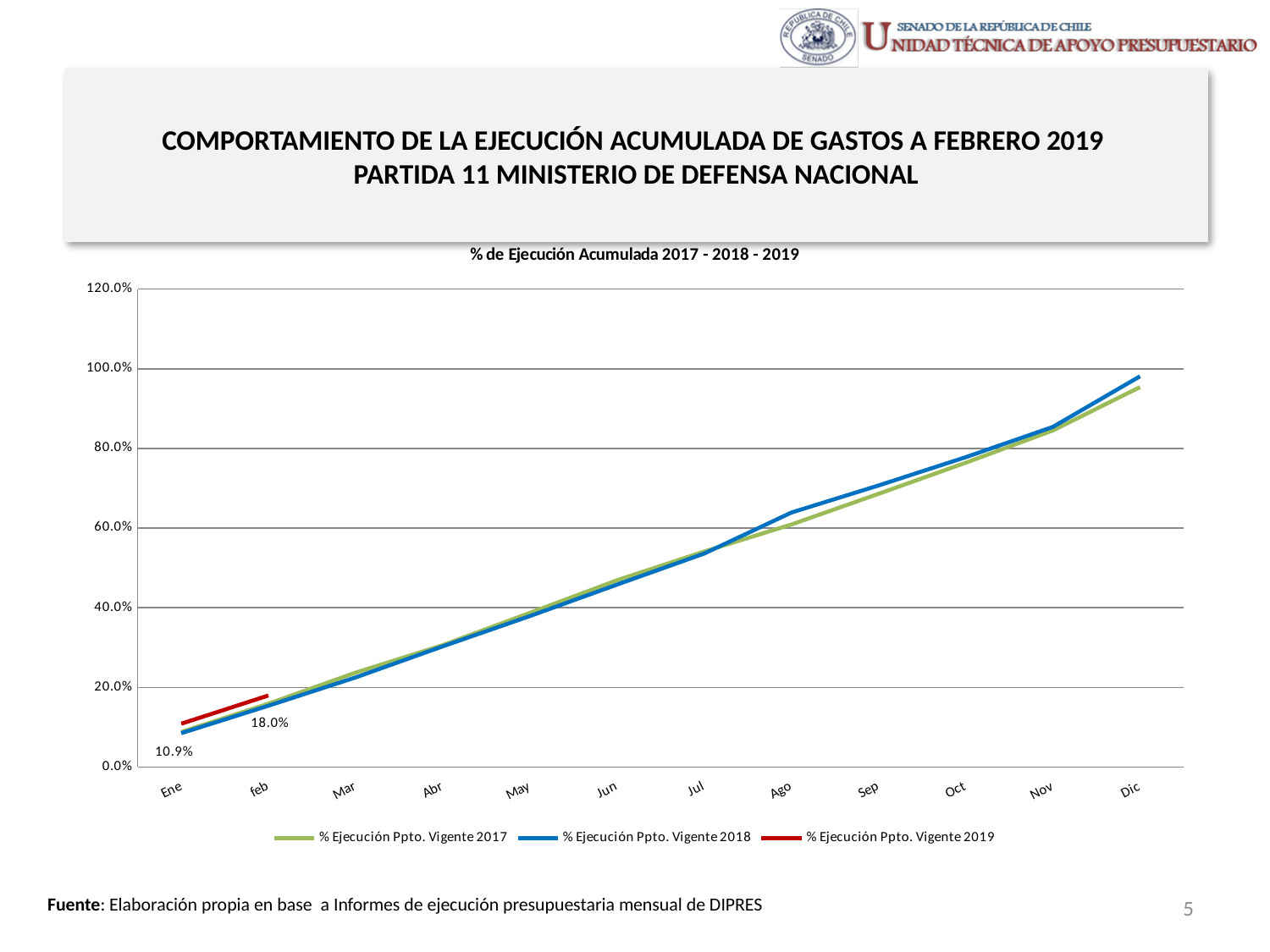
In Dic, which series has the higher value: % Ejecución Ppto. Vigente 2017 or % Ejecución Ppto. Vigente 2018? % Ejecución Ppto. Vigente 2018 How many series does the legend list? 3 What is the title of the chart? % de Ejecución Acumulada 2017 - 2018 - 2019 What kind of chart is shown on the slide? Line chart How many months are shown on the x axis? 12 What is the value of % Ejecución Ppto. Vigente 2019 for Ene? 10.9% Do the values for % Ejecución Ppto. Vigente 2018 rise or fall from Ene to Dic? Rise Is the value for % Ejecución Ppto. Vigente 2017 in Dic greater or less than 80.0%? greater By how many percentage points did % Ejecución Ppto. Vigente 2019 increase from Ene to feb? 7.1 percentage points Is the value for % Ejecución Ppto. Vigente 2018 in Dic greater or less than 100.0%? less What is the value of % Ejecución Ppto. Vigente 2019 for feb? 18.0% What colour is the line for % Ejecución Ppto. Vigente 2019? Red